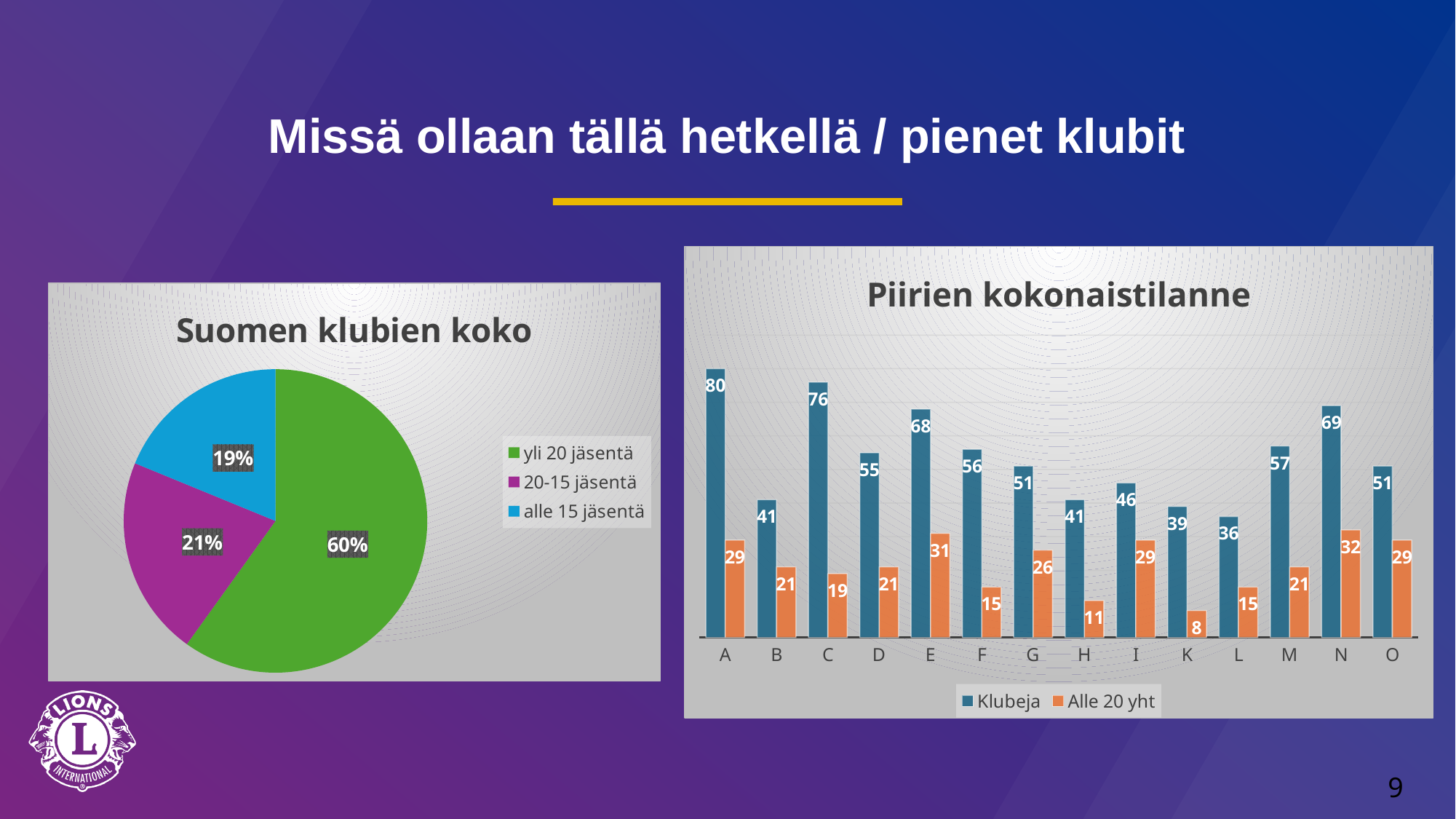
In the 'Piirien kokonaistilanne' chart, which district has the lowest 'Alle 20 yht' value? K What kind of chart is 'Suomen klubien koko'? pie chart In the 'Piirien kokonaistilanne' chart, which district has the highest Klubeja value? A In the 'Suomen klubien koko' chart, which category has the smallest slice? alle 15 jäsentä In the 'Piirien kokonaistilanne' chart, what is the 'Alle 20 yht' value for district K? 8 In the 'Piirien kokonaistilanne' chart, which is larger: the Klubeja value for district M or for district N? N What kind of chart is 'Piirien kokonaistilanne'? bar chart In the 'Piirien kokonaistilanne' chart, what is the difference between the Klubeja value and the 'Alle 20 yht' value for district E? 37 In the 'Piirien kokonaistilanne' chart, what is the Klubeja value for district C? 76 In the 'Suomen klubien koko' chart, what share of clubs has 'yli 20 jäsentä'? 60% How many series does the legend of the 'Piirien kokonaistilanne' chart list? 2 How many districts are shown on the x axis of the 'Piirien kokonaistilanne' chart? 14